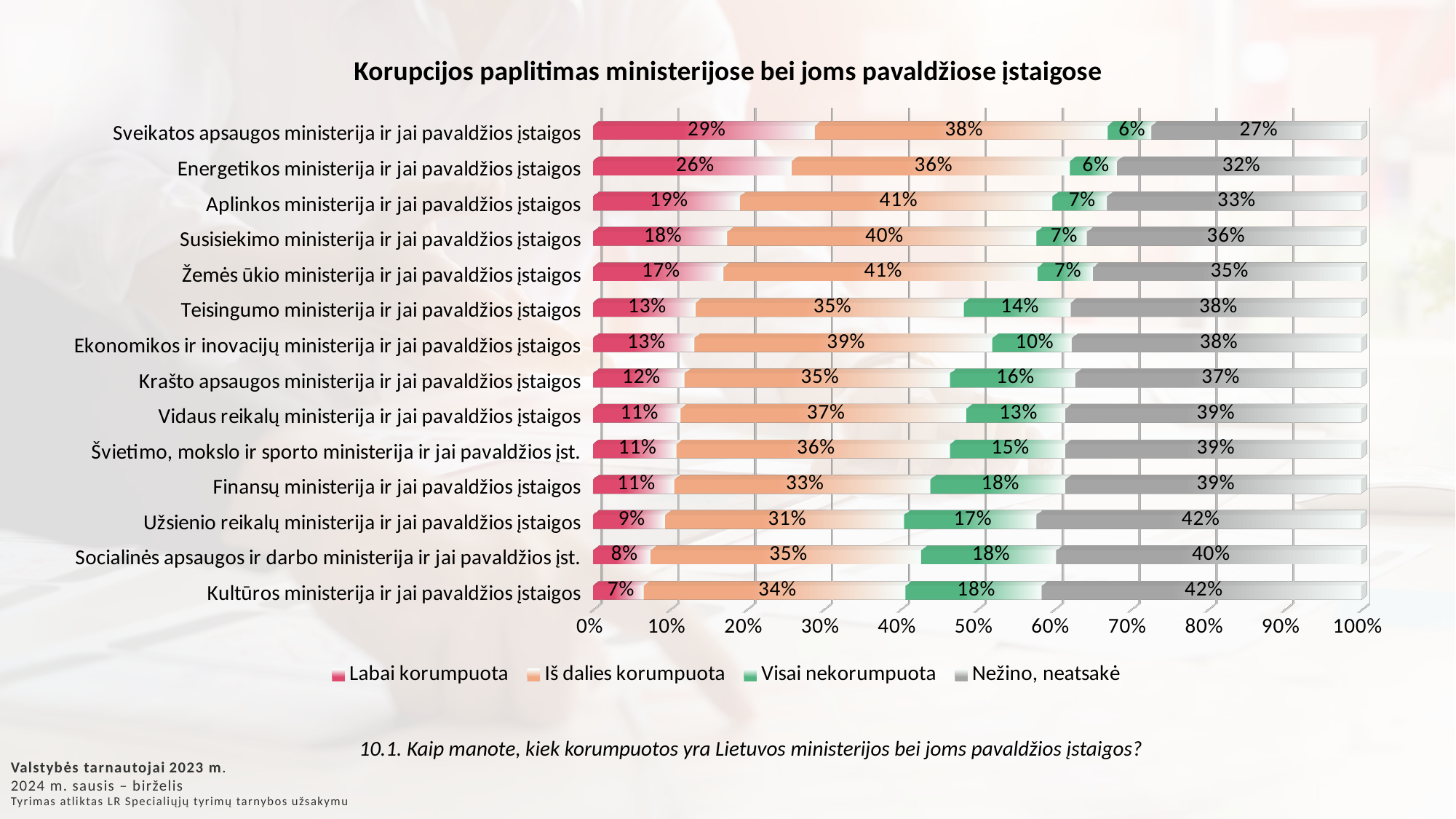
How many series does the legend list? 4 Which ministry has the lowest 'Labai korumpuota' value? Kultūros ministerija ir jai pavaldžios įstaigos What is the difference between the 'Labai korumpuota' values for Sveikatos apsaugos ministerija and Energetikos ministerija? 3% What is the 'Nežino, neatsakė' value for Užsienio reikalų ministerija ir jai pavaldžios įstaigos? 42% What is the 'Visai nekorumpuota' value for Finansų ministerija ir jai pavaldžios įstaigos? 18% How many ministries (categories) are shown in the chart? 14 Which is larger: the 'Iš dalies korumpuota' value for Aplinkos ministerija or for Finansų ministerija? Aplinkos ministerija What kind of chart is shown on the slide? Stacked bar chart What is the 'Labai korumpuota' value for Sveikatos apsaugos ministerija ir jai pavaldžios įstaigos? 29% Which legend entry is shown in green? Visai nekorumpuota Which ministry has the highest 'Labai korumpuota' value? Sveikatos apsaugos ministerija ir jai pavaldžios įstaigos What is the title of the chart? Korupcijos paplitimas ministerijose bei joms pavaldžiose įstaigose